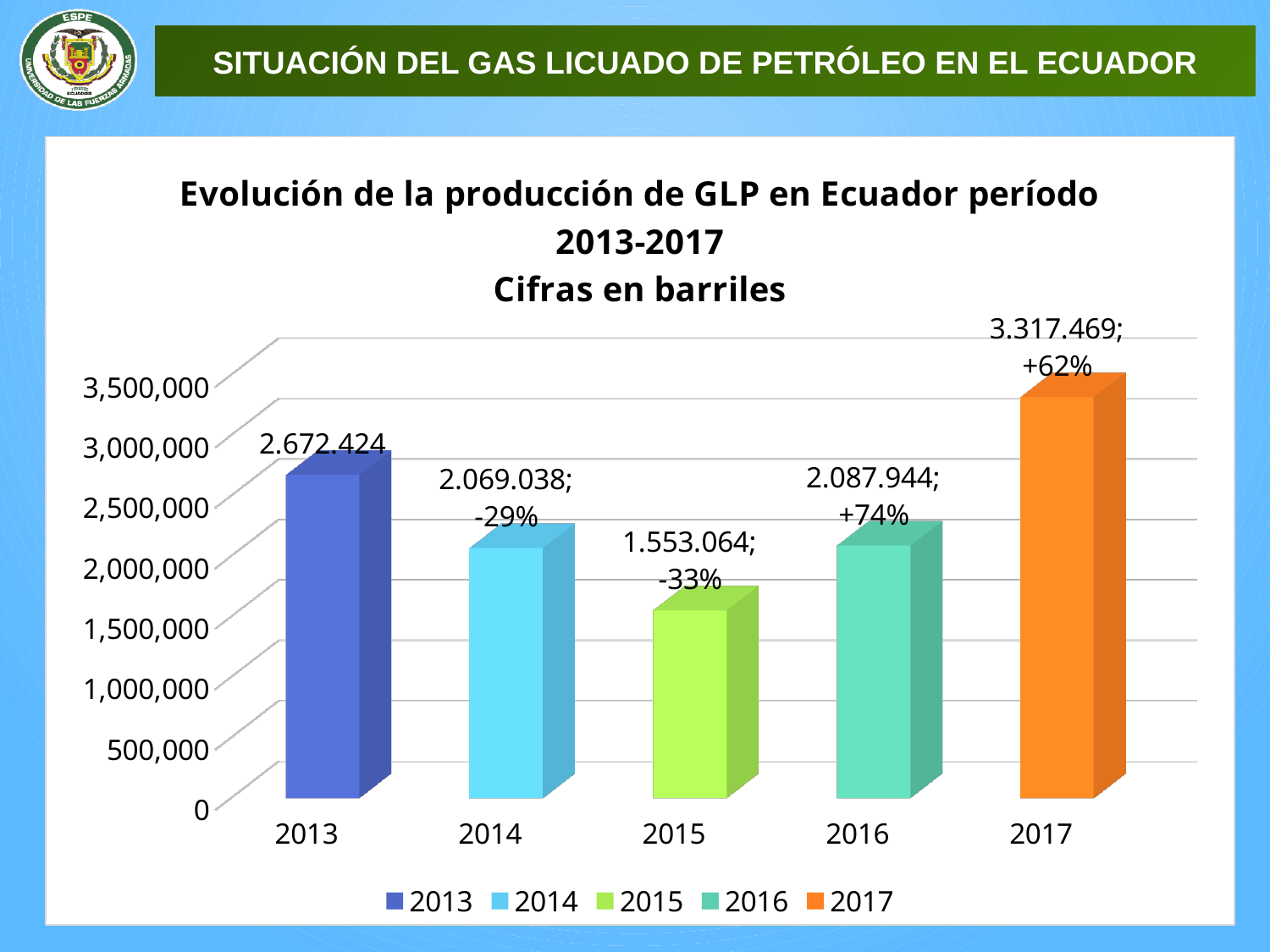
What was the GLP production in Ecuador in 2013 according to the chart? 2.672.424 What percentage change is labelled for 2014? -29% Is the value for 2017 greater or less than 3,000,000? greater Which year has the lowest GLP production in the chart? 2015 Which is larger, the value for 2013 or the value for 2016? 2013 Which year has the highest GLP production in the chart? 2017 Do the values rise or fall from 2013 to 2015? fall What kind of chart is shown on the slide? bar chart How many years are plotted in the chart? 5 What value is shown for 2015 in the chart? 1.553.064 What is the difference in barrels between the 2017 and 2013 values? 645.045 What percentage change is labelled for 2016? +74%